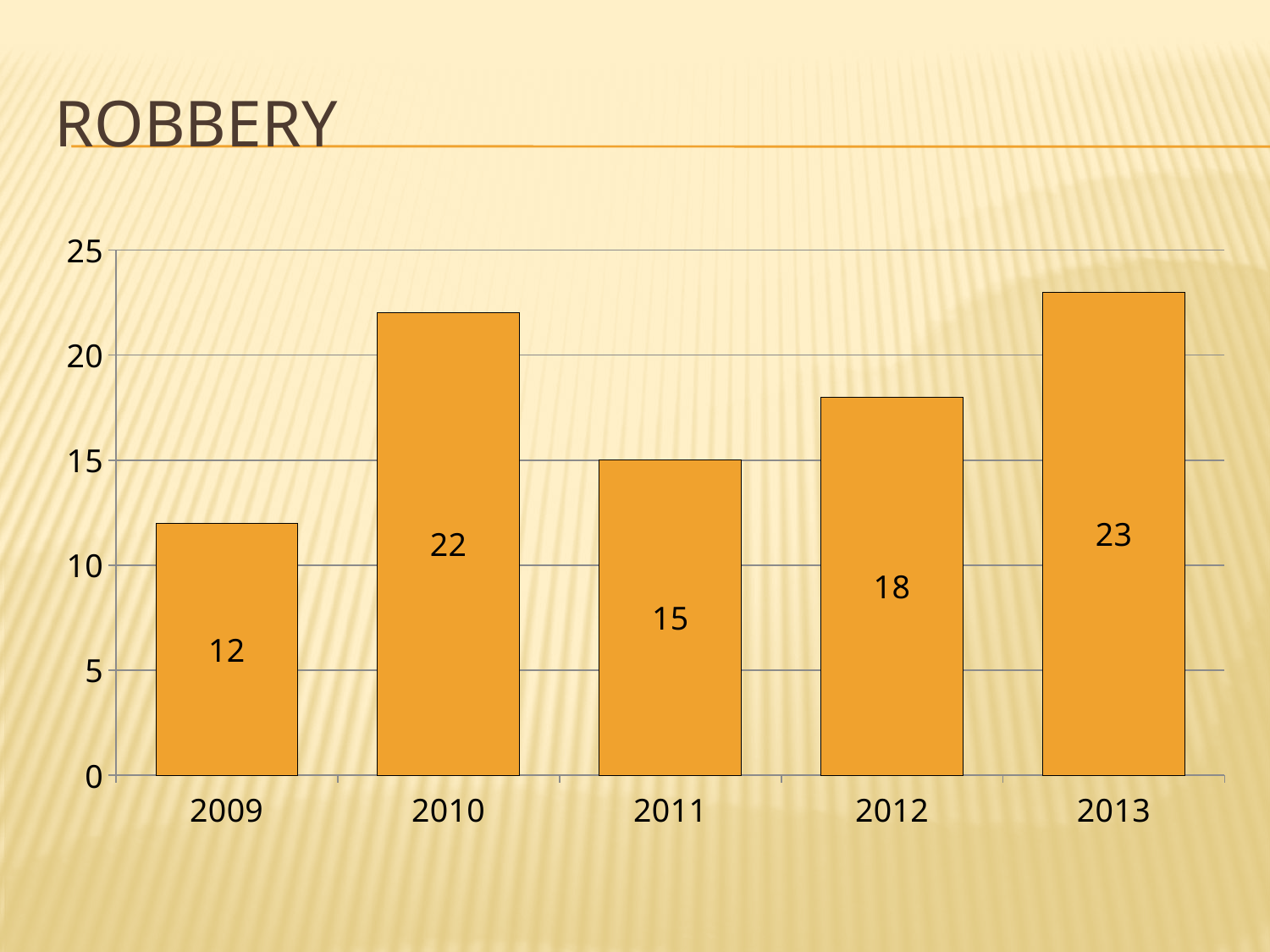
Which year has the highest value? 2013 What is the difference between the values for 2013 and 2009? 11 Is the value for 2012 greater or less than 15? greater What is the value for 2013? 23 How many years are shown on the x axis? 5 What is the difference between the values for 2010 and 2011? 7 Which is larger, the value for 2010 or the value for 2012? 2010 What is the value for 2009? 12 What is the value for 2011? 15 Which year has the lowest value? 2009 What kind of chart is shown on the slide? bar chart What is the title of the slide? ROBBERY